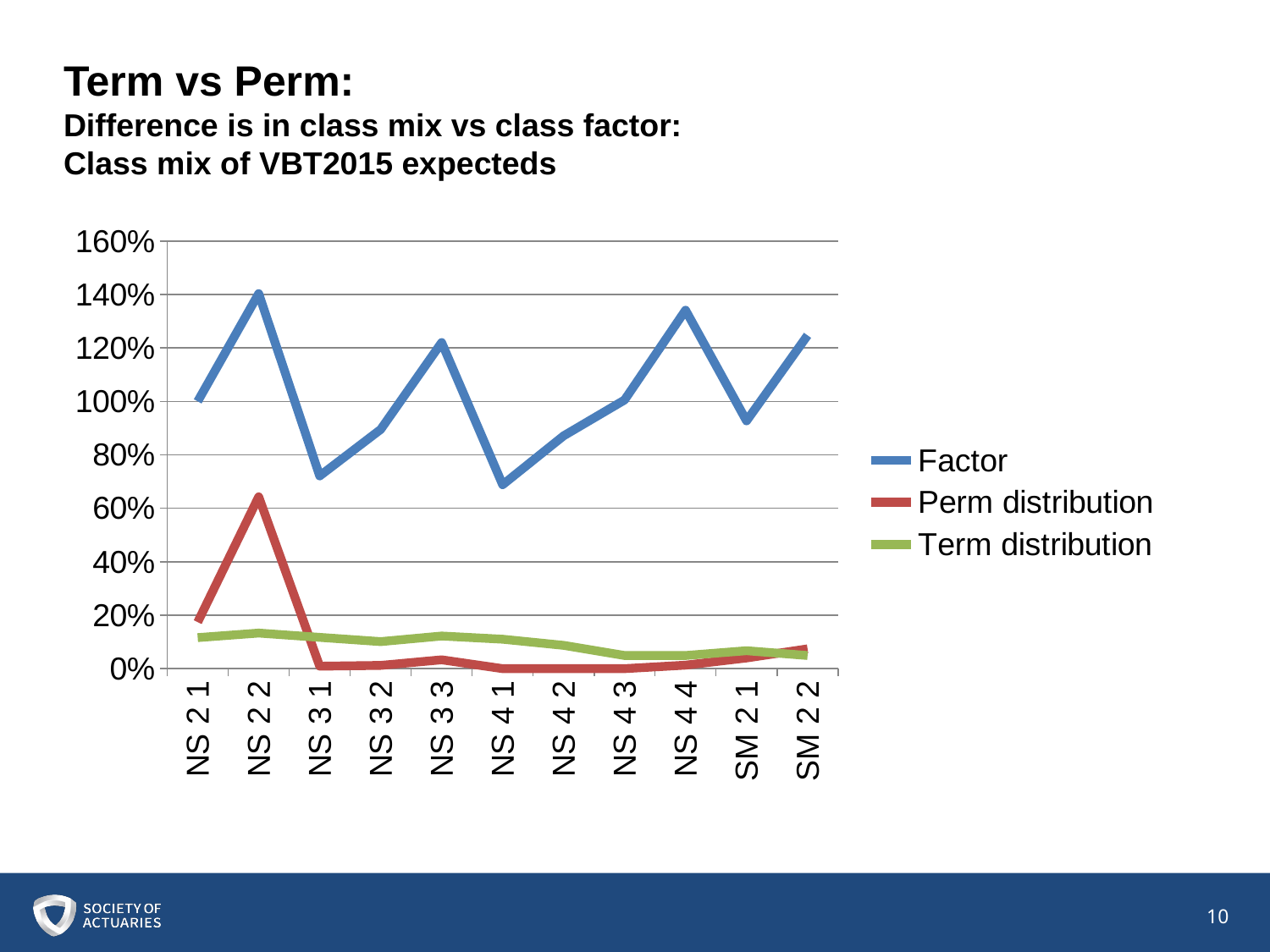
What kind of chart is shown on the slide? line chart Which category has the highest Factor value? NS 2 2 At NS 4 1, which is larger: Perm distribution or Term distribution? Term distribution Is the Perm distribution value for NS 2 2 greater or less than 40%? greater Which colour is used for the Factor series? blue How many series does the legend list? 3 At NS 2 2, which is larger: Perm distribution or Term distribution? Perm distribution How many categories are shown on the x axis? 11 Is the Factor value for NS 4 1 greater or less than 80%? less Is the Factor value for NS 2 2 greater or less than 120%? greater Which category has the highest Perm distribution value? NS 2 2